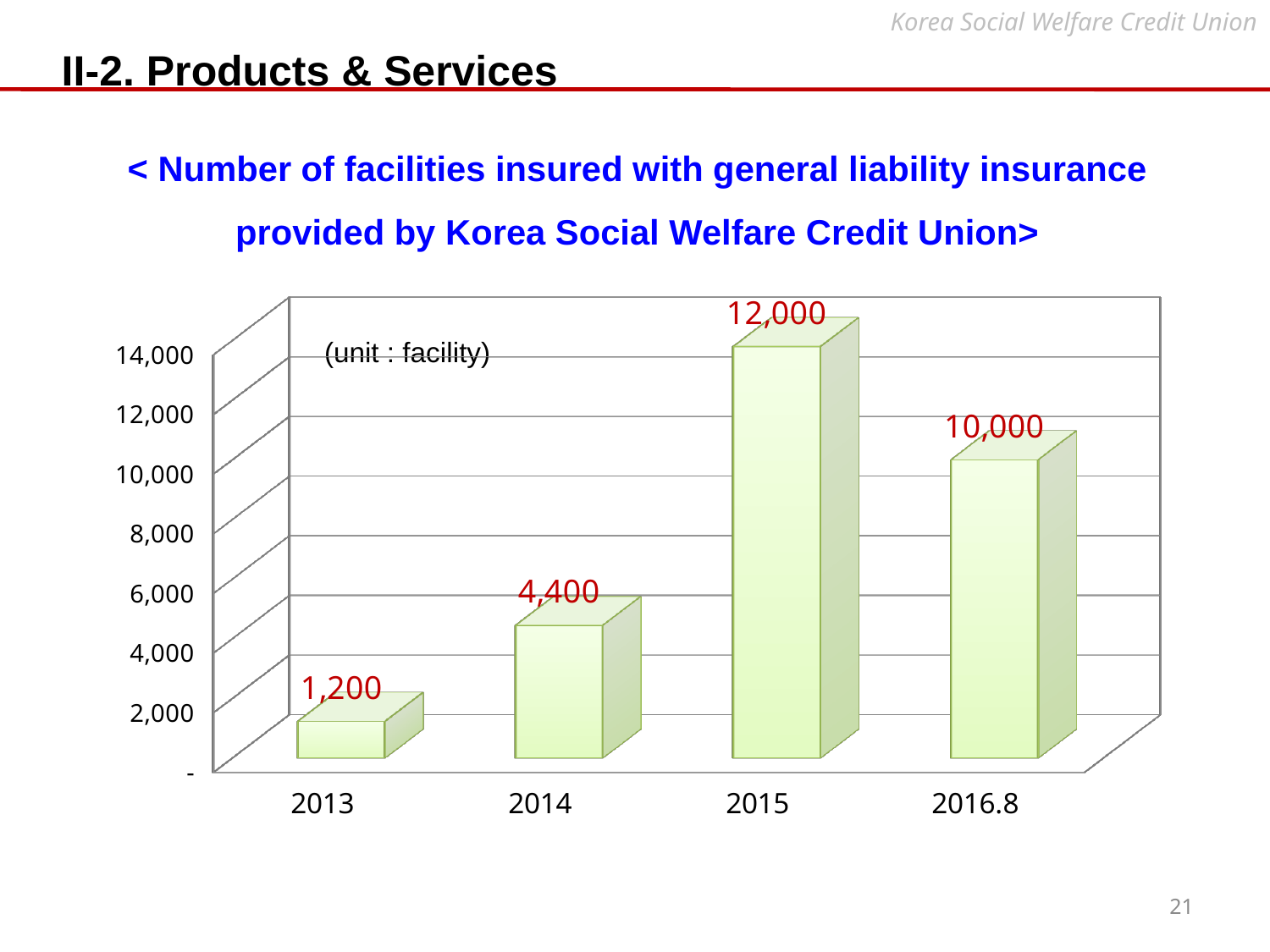
How many categories are shown on the x axis? 4 Which year has the highest number of insured facilities? 2015 Which year has the lowest number of insured facilities? 2013 What unit is stated for the values in the chart? facility What is the difference between the number of facilities in 2014 and in 2013? 3,200 What is the number of facilities insured in 2015? 12,000 What kind of chart is shown on the slide? Bar chart What is the difference between the number of facilities in 2015 and in 2014? 7,600 Which is larger, the value for 2015 or the value for 2016.8? 2015 What is the number of facilities insured in 2013? 1,200 What is the number of facilities insured as of 2016.8? 10,000 What is the number of facilities insured in 2014? 4,400